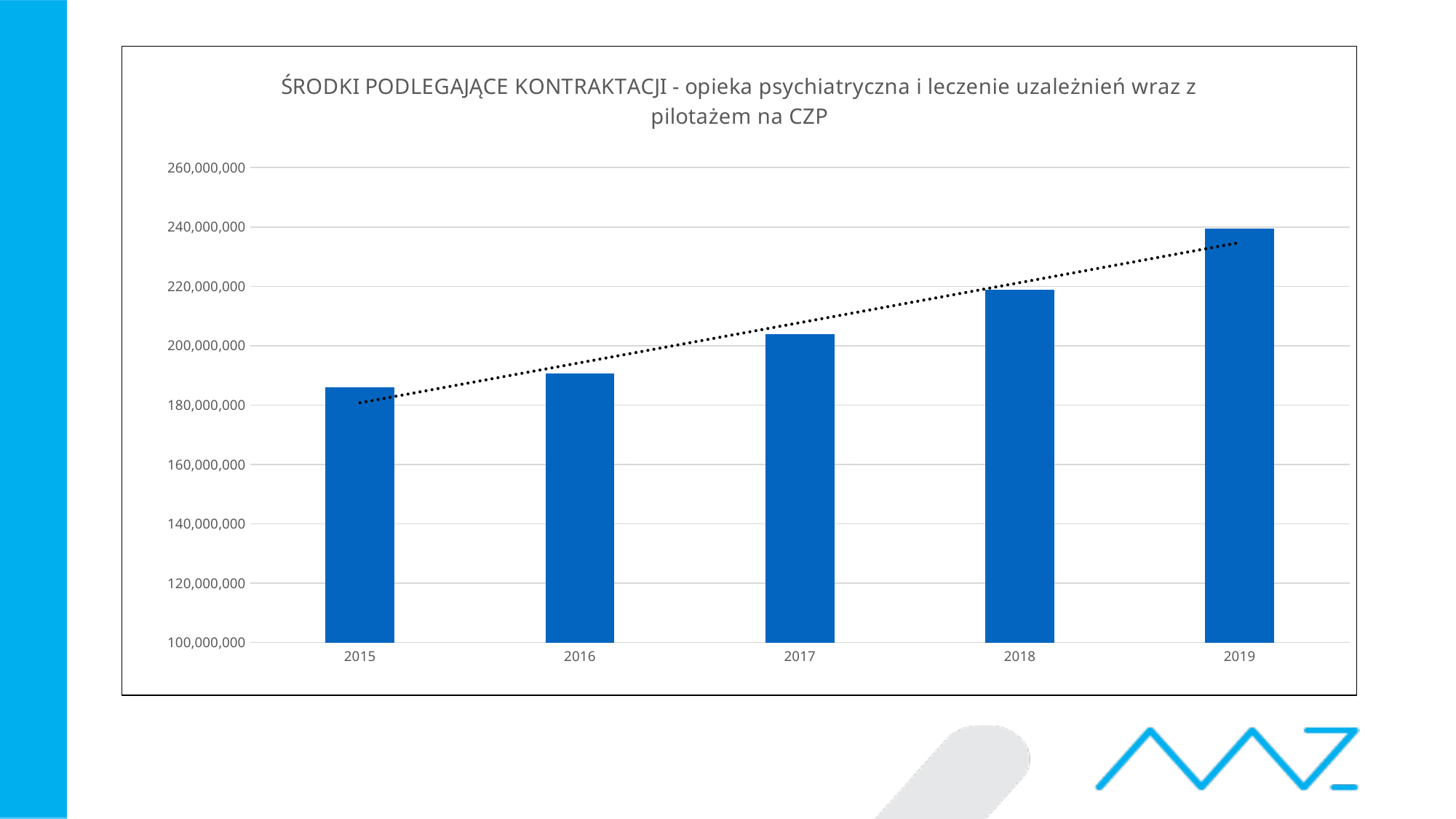
How many years are shown on the x axis of the chart? 5 Is the value for 2016 greater or less than 200,000,000? less Is the value for 2015 greater or less than 180,000,000? greater What is the first year shown on the x axis of the chart? 2015 Is the value for 2019 greater or less than 220,000,000? greater What kind of chart is shown on the slide? bar chart Which is larger, the value for 2018 or the value for 2016? 2018 What is the highest value labelled on the vertical axis of the chart? 260,000,000 Which year has the lowest value in the chart? 2015 Do the values rise or fall from 2015 to 2019? rise Which year has the highest value in the chart? 2019